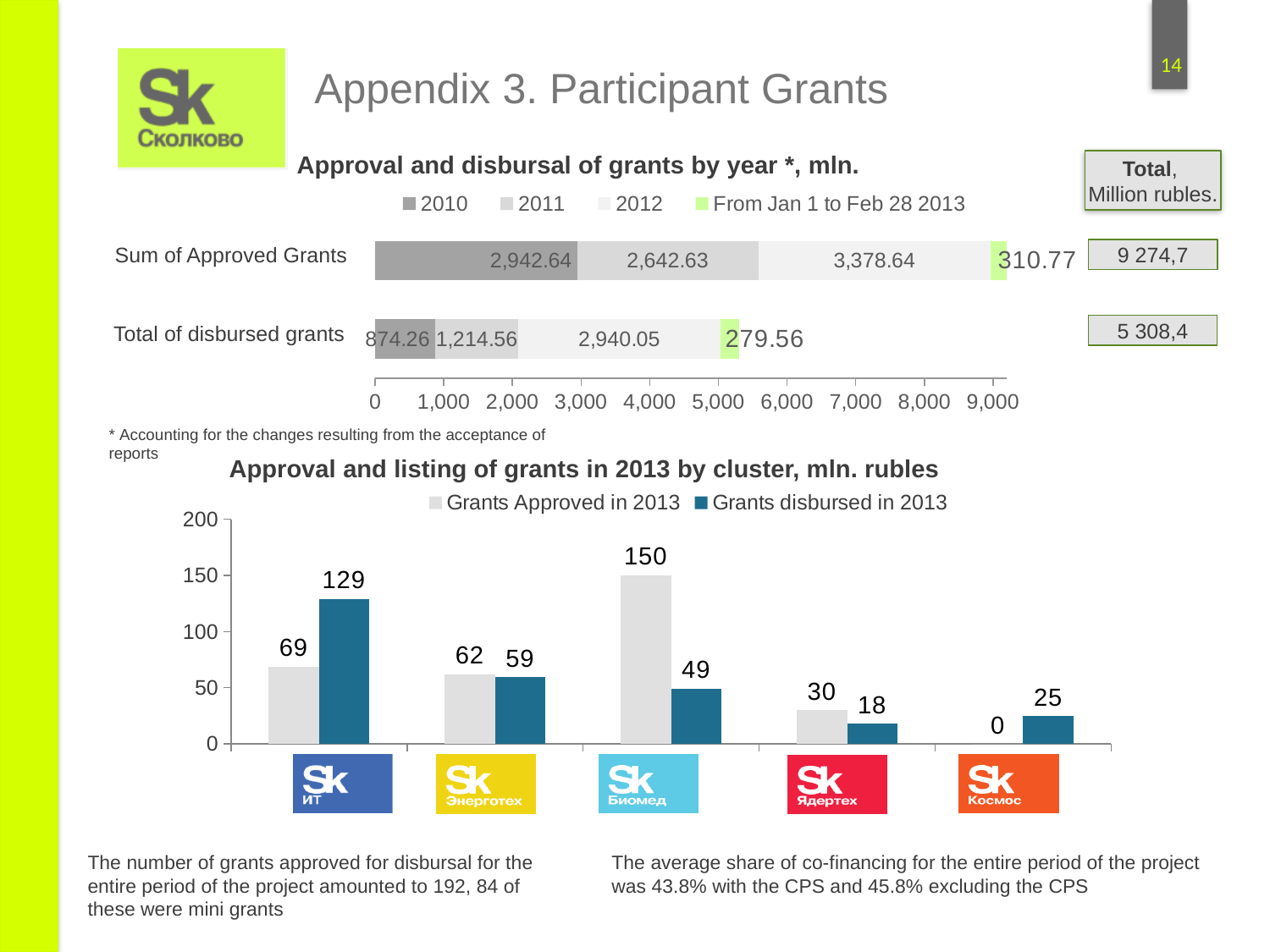
In the 'Approval and listing of grants in 2013 by cluster' chart, what is the difference between Grants Approved in 2013 and Grants disbursed in 2013 for Биомед? 101 In the 'Approval and disbursal of grants by year' chart, which year has the largest value for Sum of Approved Grants? 2012 What kind of chart is the 'Approval and disbursal of grants by year' chart? Stacked bar chart In the 'Approval and listing of grants in 2013 by cluster' chart, what is the value of Grants Approved in 2013 for Биомед? 150 How many clusters are shown in the 'Approval and listing of grants in 2013 by cluster' chart? 5 In the 'Approval and listing of grants in 2013 by cluster' chart, which cluster has the lowest value of Grants Approved in 2013? Космос In the 'Approval and disbursal of grants by year' chart, what is the 2012 value for Sum of Approved Grants? 3,378.64 In the 'Approval and disbursal of grants by year' chart, what is the 2010 value for Total of disbursed grants? 874.26 In the 'Approval and disbursal of grants by year' chart, what is the difference between the 2012 values for Sum of Approved Grants and Total of disbursed grants? 438.59 In the 'Approval and listing of grants in 2013 by cluster' chart, what is the value of Grants disbursed in 2013 for ИТ? 129 In the 'Approval and disbursal of grants by year' chart, how many series does the legend list? 4 In the 'Approval and listing of grants in 2013 by cluster' chart, which is larger for Энерготех: Grants Approved in 2013 or Grants disbursed in 2013? Grants Approved in 2013